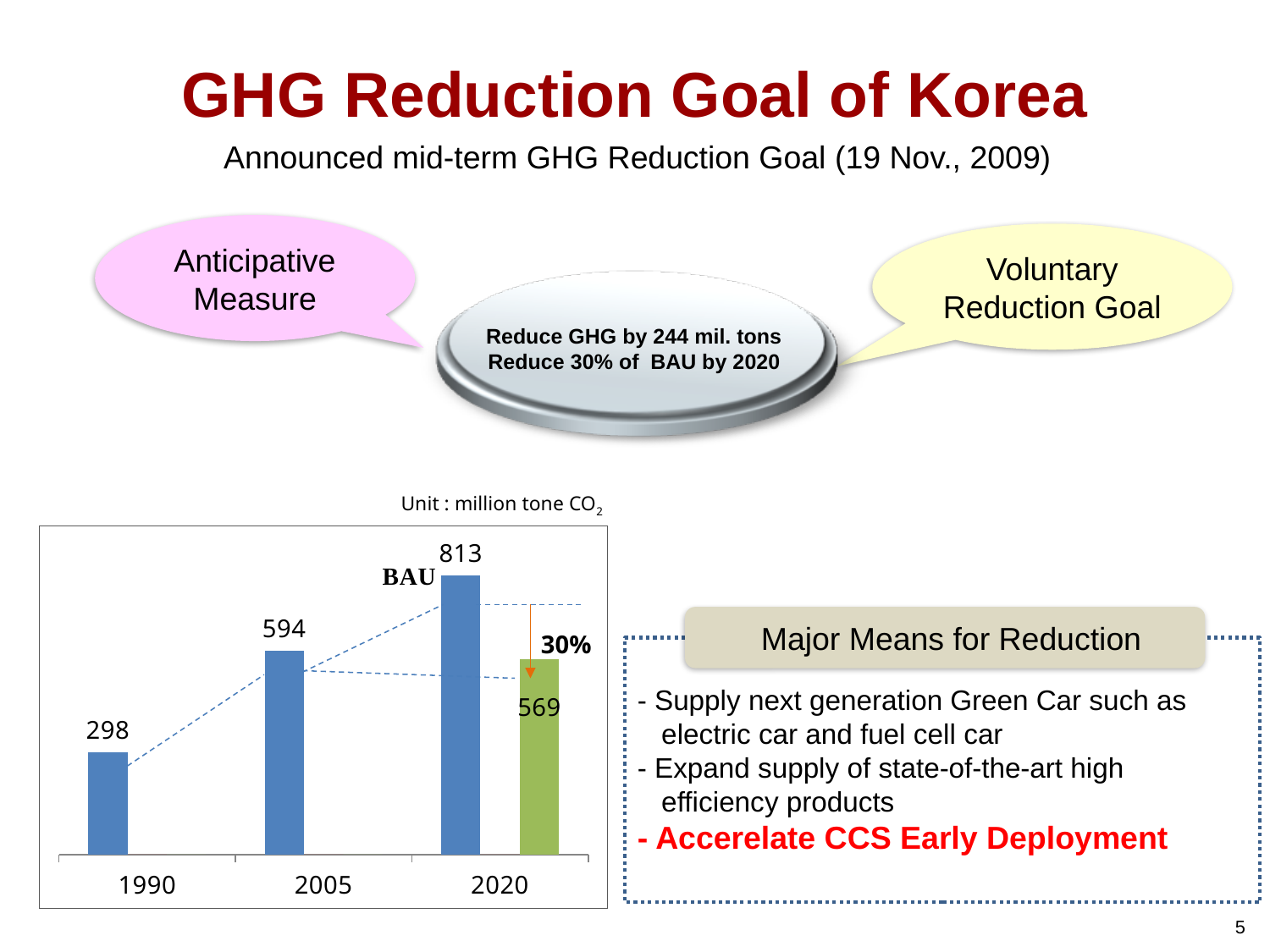
How many years are labelled on the x axis of the chart? 3 Which bar is the tallest in the chart? 2020 BAU (813) What is the difference between the 2020 BAU value and the green 2020 bar? 244 Which year has the lowest value in the chart? 1990 What kind of chart is shown on the slide? bar chart What is the difference between the 2005 value and the 1990 value? 296 Which is larger, the 2005 value or the green 2020 bar? 2005 (594) What unit is stated above the chart? million tone CO2 What is the value for 1990 in the chart? 298 What is the value for 2005 in the chart? 594 What is the value of the green bar for 2020 in the chart? 569 What is the BAU value for 2020 in the chart? 813